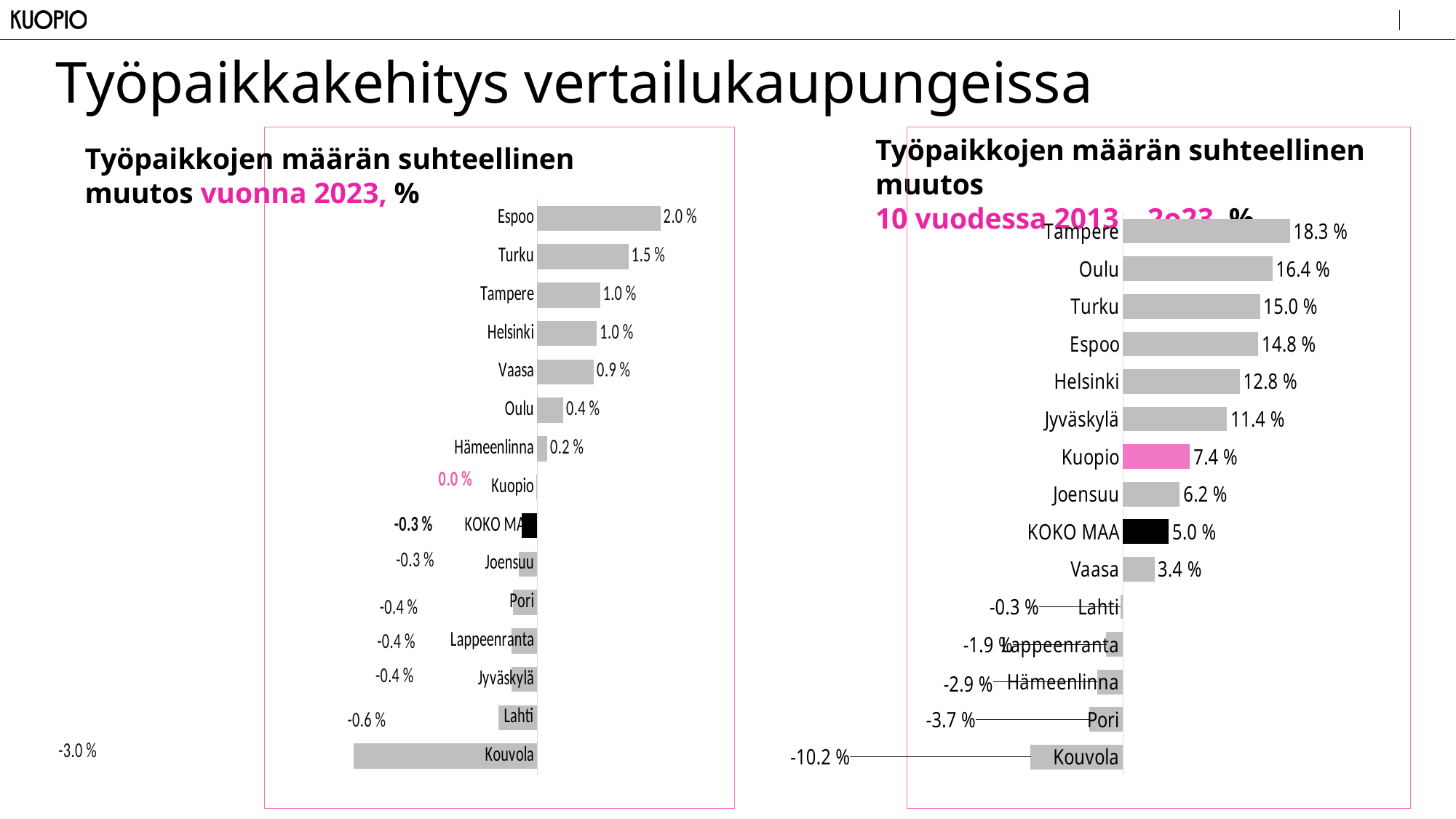
In the left chart (change in 2023), how many categories are shown? 15 In the right chart (change over 10 years 2013–2023), which is larger, Oulu or Turku? Oulu In the right chart (change over 10 years 2013–2023), what is the value for Kuopio? 7.4 % What type of chart is the right chart? Bar chart In the left chart (change in 2023), what is the value for Kouvola? -3.0 % In the right chart (change over 10 years 2013–2023), which city has the highest value? Tampere In the left chart (change in 2023), which city has the lowest value? Kouvola In the left chart (change in 2023), what is the value for Espoo? 2.0 % In the left chart (change in 2023), what is the difference between Espoo and Turku? 0.5 % In the left chart (change in 2023), which city has the highest value? Espoo In the right chart (change over 10 years 2013–2023), which city has the lowest value? Kouvola In the right chart (change over 10 years 2013–2023), what is the value for KOKO MAA? 5.0 %